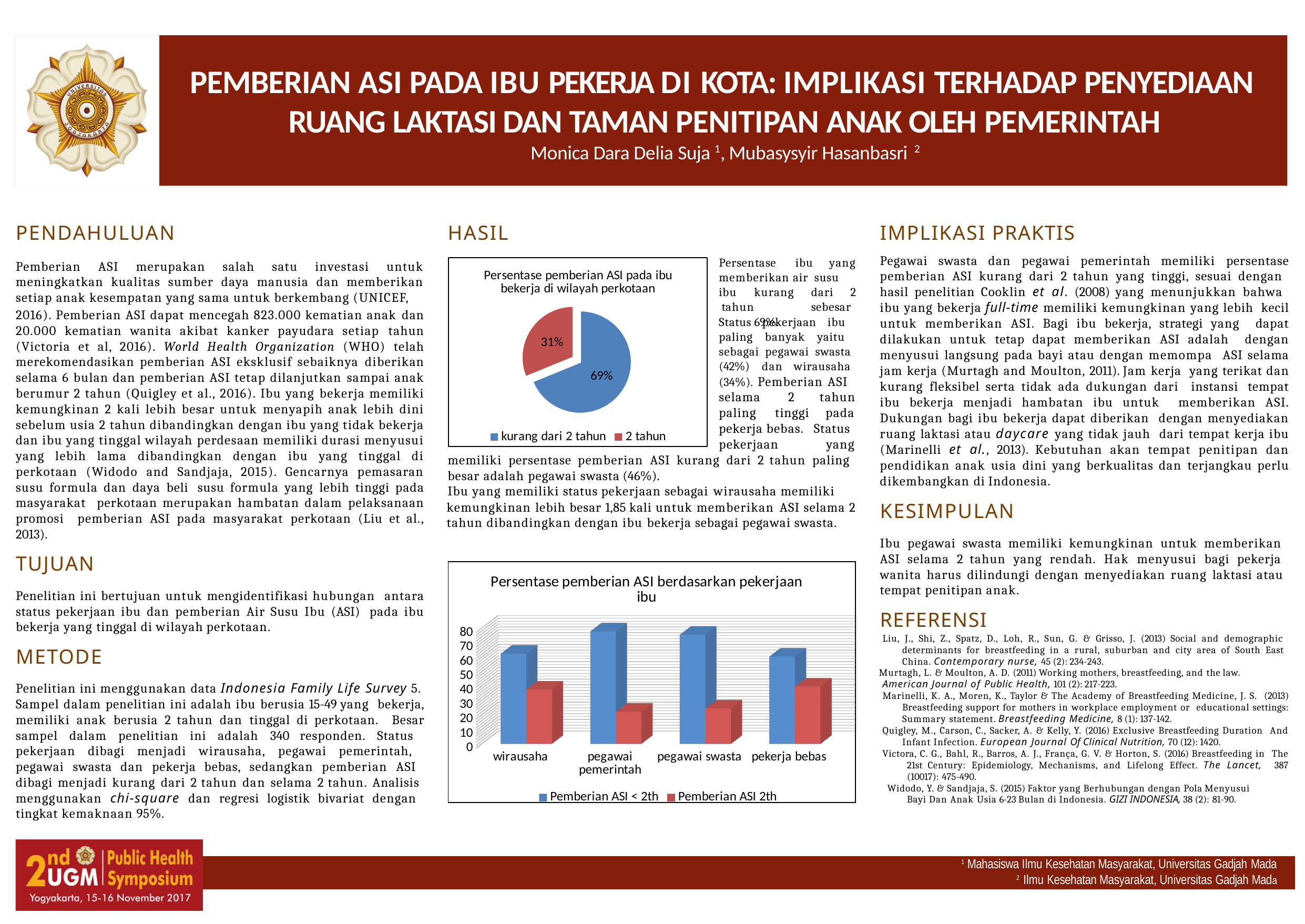
What type of chart is 'Persentase pemberian ASI berdasarkan pekerjaan ibu'? bar chart In the pie chart 'Persentase pemberian ASI pada ibu bekerja di wilayah perkotaan', what is the difference in percentage points between 'kurang dari 2 tahun' and '2 tahun'? 38 In the chart 'Persentase pemberian ASI berdasarkan pekerjaan ibu', how many series does the legend list? 2 In the pie chart 'Persentase pemberian ASI pada ibu bekerja di wilayah perkotaan', what percentage is shown for '2 tahun'? 31% In the chart 'Persentase pemberian ASI berdasarkan pekerjaan ibu', which colour represents 'Pemberian ASI 2th'? red In the pie chart 'Persentase pemberian ASI pada ibu bekerja di wilayah perkotaan', what percentage is shown for 'kurang dari 2 tahun'? 69% In the chart 'Persentase pemberian ASI berdasarkan pekerjaan ibu', is the 'Pemberian ASI < 2th' value for wirausaha greater or less than 50? greater In the chart 'Persentase pemberian ASI berdasarkan pekerjaan ibu', which is larger for 'Pemberian ASI < 2th': wirausaha or pegawai pemerintah? pegawai pemerintah In the pie chart 'Persentase pemberian ASI pada ibu bekerja di wilayah perkotaan', which slice is the largest? kurang dari 2 tahun In the chart 'Persentase pemberian ASI berdasarkan pekerjaan ibu', is the 'Pemberian ASI 2th' value for pegawai pemerintah greater or less than 30? less In the chart 'Persentase pemberian ASI berdasarkan pekerjaan ibu', how many occupation categories are shown on the x axis? 4 In the pie chart 'Persentase pemberian ASI pada ibu bekerja di wilayah perkotaan', how many slices are there? 2